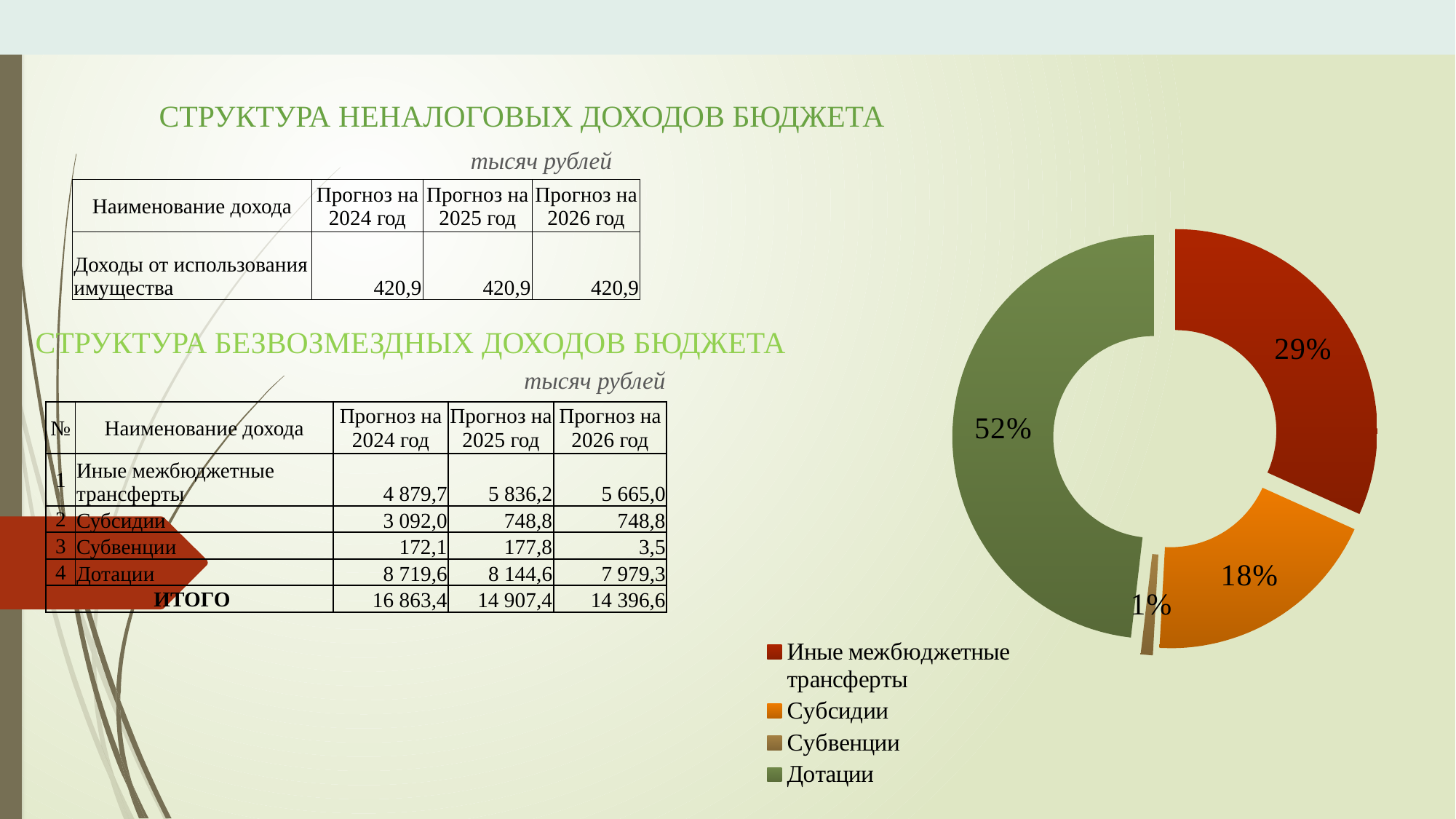
What share of the doughnut chart does Иные межбюджетные трансферты represent? 29% What type of chart is shown on the right side of the slide? Doughnut (pie) chart What share of the doughnut chart does Субвенции represent? 1% How many slices does the doughnut chart have? 4 What share of the doughnut chart does Субсидии represent? 18% How many entries does the legend of the doughnut chart list? 4 Which category has the largest slice in the doughnut chart? Дотации In the doughnut chart, which is larger: the share for Субсидии or the share for Иные межбюджетные трансферты? Иные межбюджетные трансферты Which category has the smallest slice in the doughnut chart? Субвенции What is the difference in percentage points between the Дотации slice and the Иные межбюджетные трансферты slice in the doughnut chart? 23 What is the difference in percentage points between the Субсидии slice and the Субвенции slice in the doughnut chart? 17